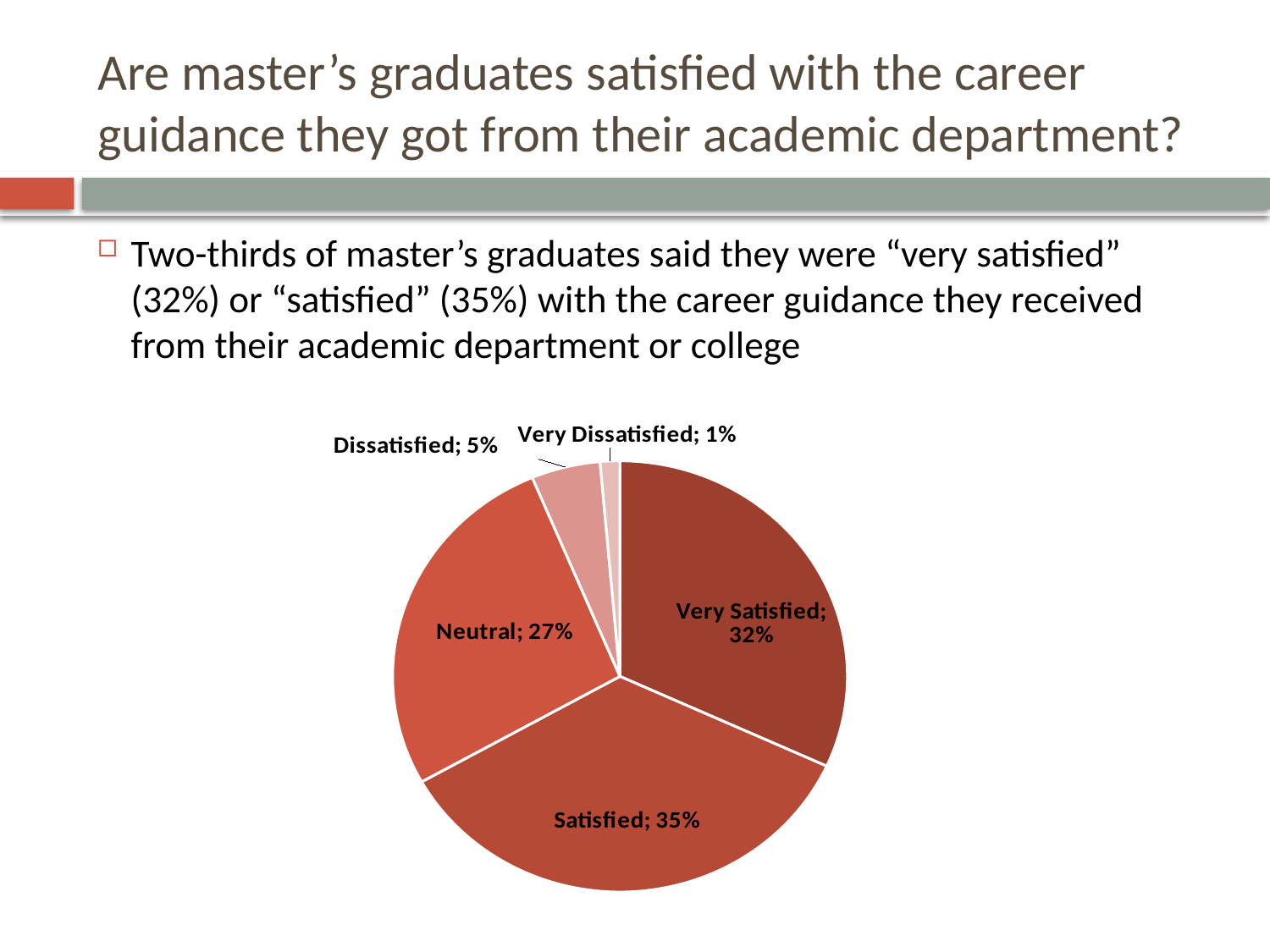
What is the combined percentage of the Very Satisfied and Satisfied slices? 67% What percentage of master's graduates were Very Satisfied with the career guidance? 32% How many slices does the pie chart have? 5 What is the difference in percentage points between the Satisfied and Very Satisfied slices? 3 Which is larger, the Neutral slice or the Dissatisfied slice? Neutral What is the combined percentage of the Dissatisfied and Very Dissatisfied slices? 6% What share of the pie is labelled Neutral? 27% Which category has the smallest slice of the pie? Very Dissatisfied What percentage is shown for the Dissatisfied slice? 5% What kind of chart is shown on the slide? pie chart Which category has the largest slice of the pie? Satisfied What percentage is shown for the Very Dissatisfied slice? 1%